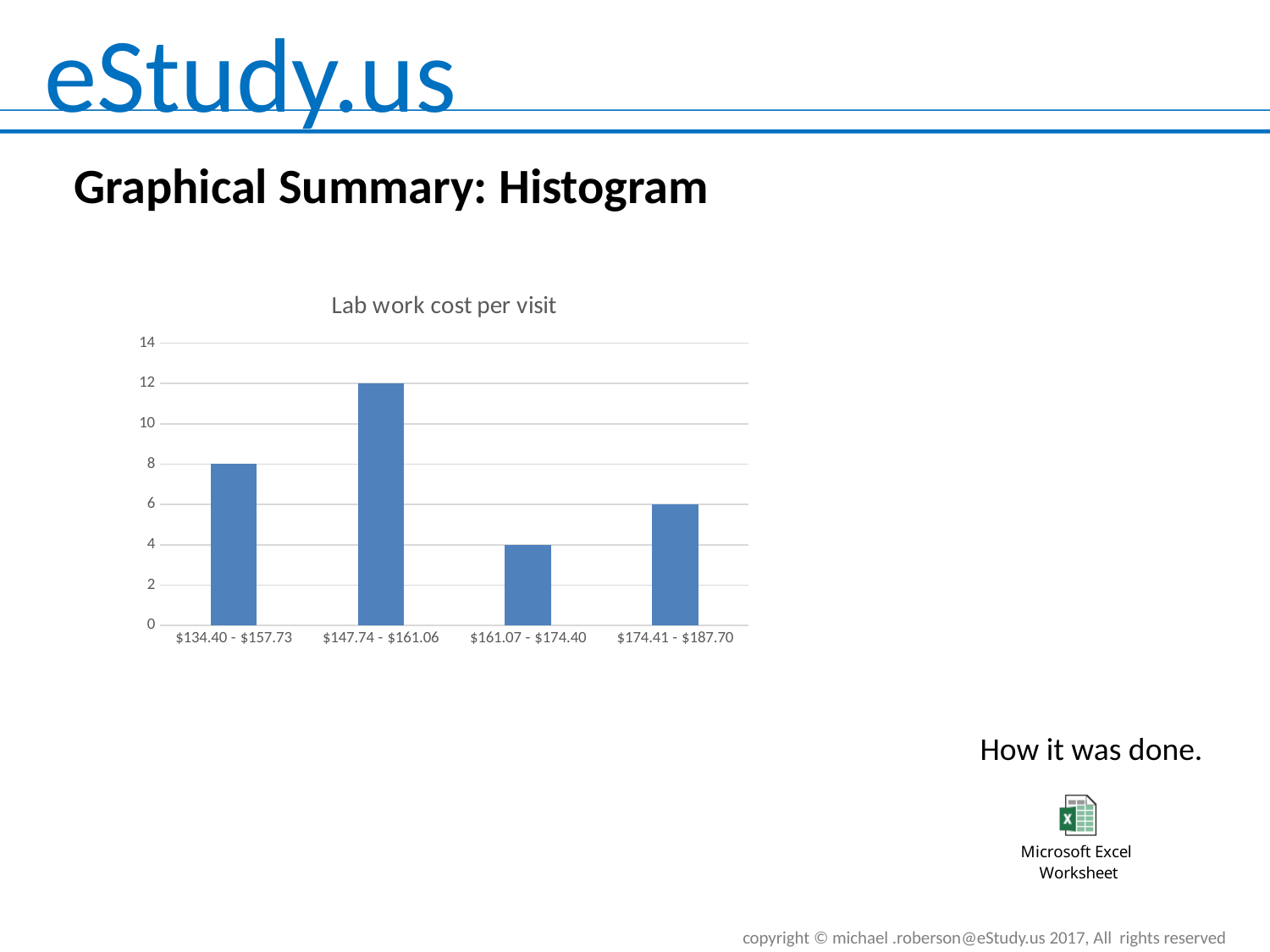
Which category has the highest value? $147.74 - $161.06 What is the value for the $161.07 - $174.40 category? 4 What is the value for the $134.40 - $157.73 category? 8 What is the value for the $174.41 - $187.70 category? 6 What kind of chart is shown on the slide? bar chart What is the title of the chart? Lab work cost per visit Is the value for $147.74 - $161.06 greater or less than 10? greater What is the value for the $147.74 - $161.06 category? 12 What is the difference between the values for $147.74 - $161.06 and $161.07 - $174.40? 8 Which category has the lowest value? $161.07 - $174.40 How many bars (categories) does the chart show? 4 Which is larger, the value for $134.40 - $157.73 or the value for $174.41 - $187.70? $134.40 - $157.73